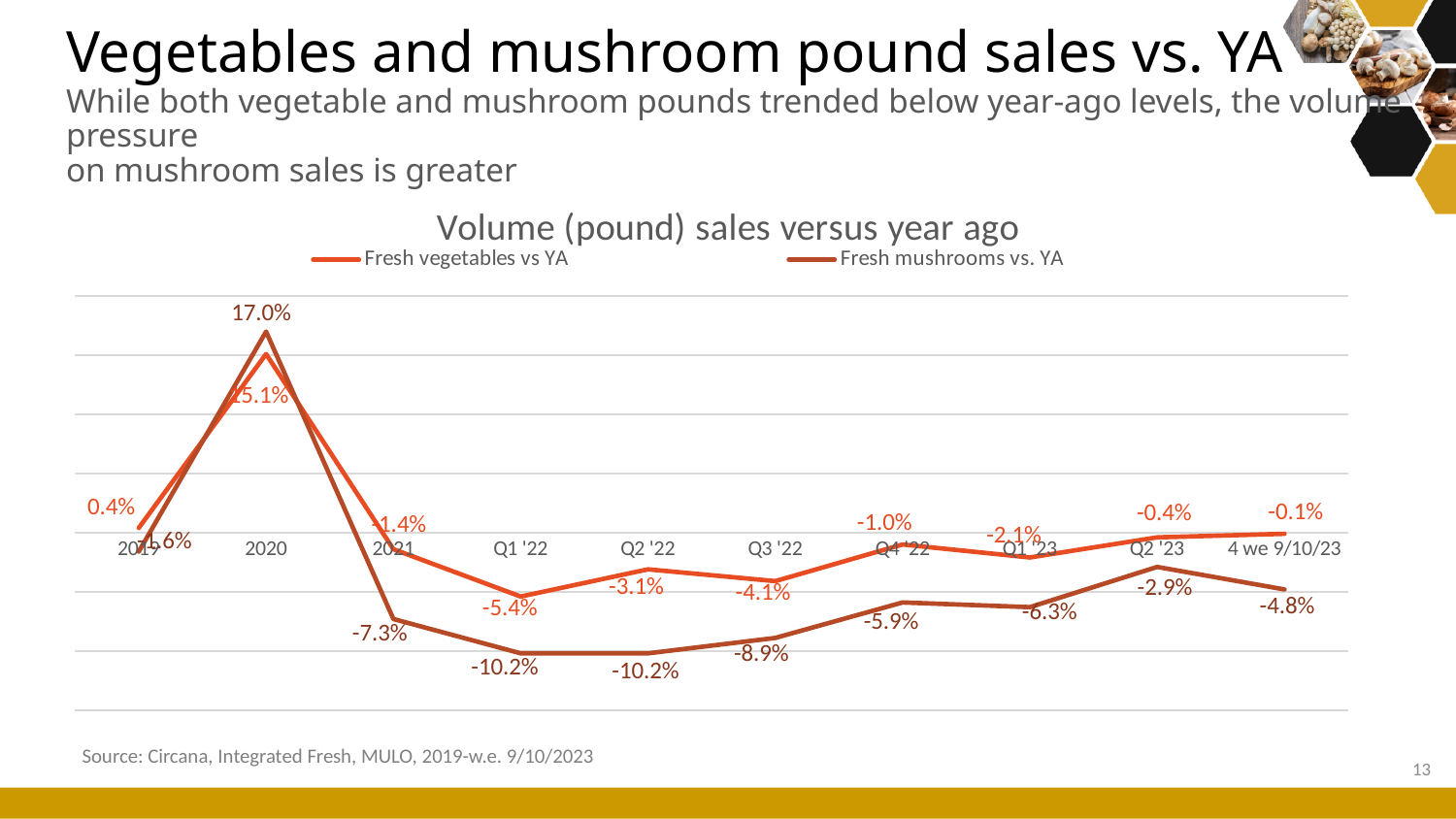
In which period is the Fresh vegetables vs YA value lowest? Q1 '22 In Q4 '22, which series has the higher value: Fresh vegetables vs YA or Fresh mushrooms vs. YA? Fresh vegetables vs YA In Q2 '23, what is the difference between the Fresh vegetables vs YA value (-0.4%) and the Fresh mushrooms vs. YA value (-2.9%)? 2.5 percentage points Does the Fresh mushrooms vs. YA value rise or fall from 2020 to Q1 '22? Fall What is the value for Fresh vegetables vs YA for the 4 we 9/10/23 period? -0.1% What is the value for Fresh mushrooms vs. YA in 2020? 17.0% In which period is the Fresh mushrooms vs. YA value highest? 2020 How many periods are shown on the x axis of the chart? 10 What type of chart is shown on the slide? Line chart How many series does the chart's legend list? 2 What is the value for Fresh mushrooms vs. YA in Q3 '22? -8.9% What is the value for Fresh vegetables vs YA in Q1 '22? -5.4%